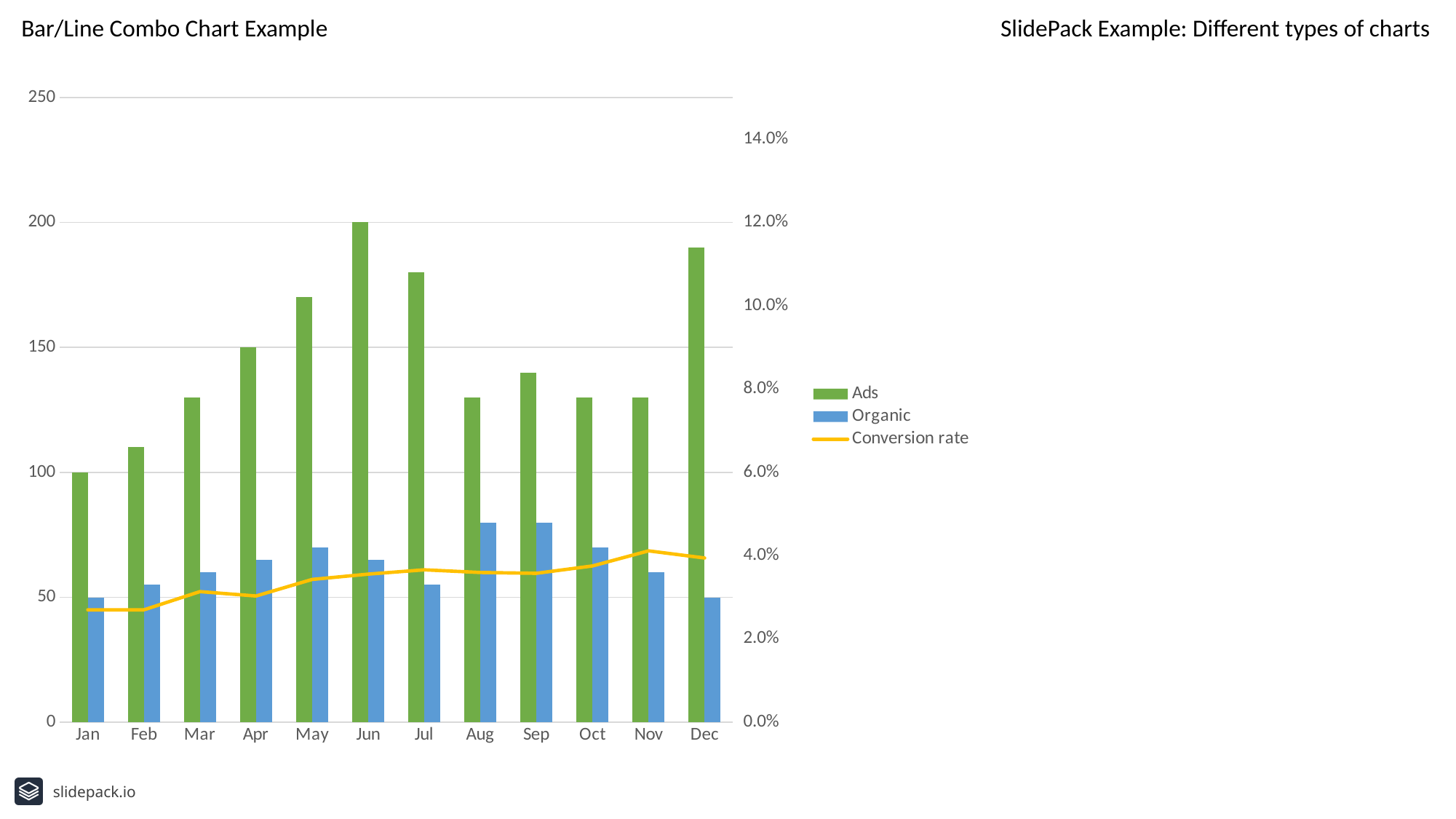
What is the Ads value for Jan? 100 Is the Ads value for Dec greater or less than 150? greater Which month has the highest Ads value? Jun How many months are shown along the x axis? 12 Which month has the lowest Ads value? Jan What type of chart is shown on the slide? Bar/line combo chart What is the Ads value for Jun? 200 Does the Conversion rate line rise or fall from Jan to Nov? rises What is the difference between the Ads value for Jun and the Ads value for Jan? 100 Which is larger, the Organic value for Aug or the Organic value for Jan? Aug How many series does the legend list? 3 What is the Ads value for Apr? 150